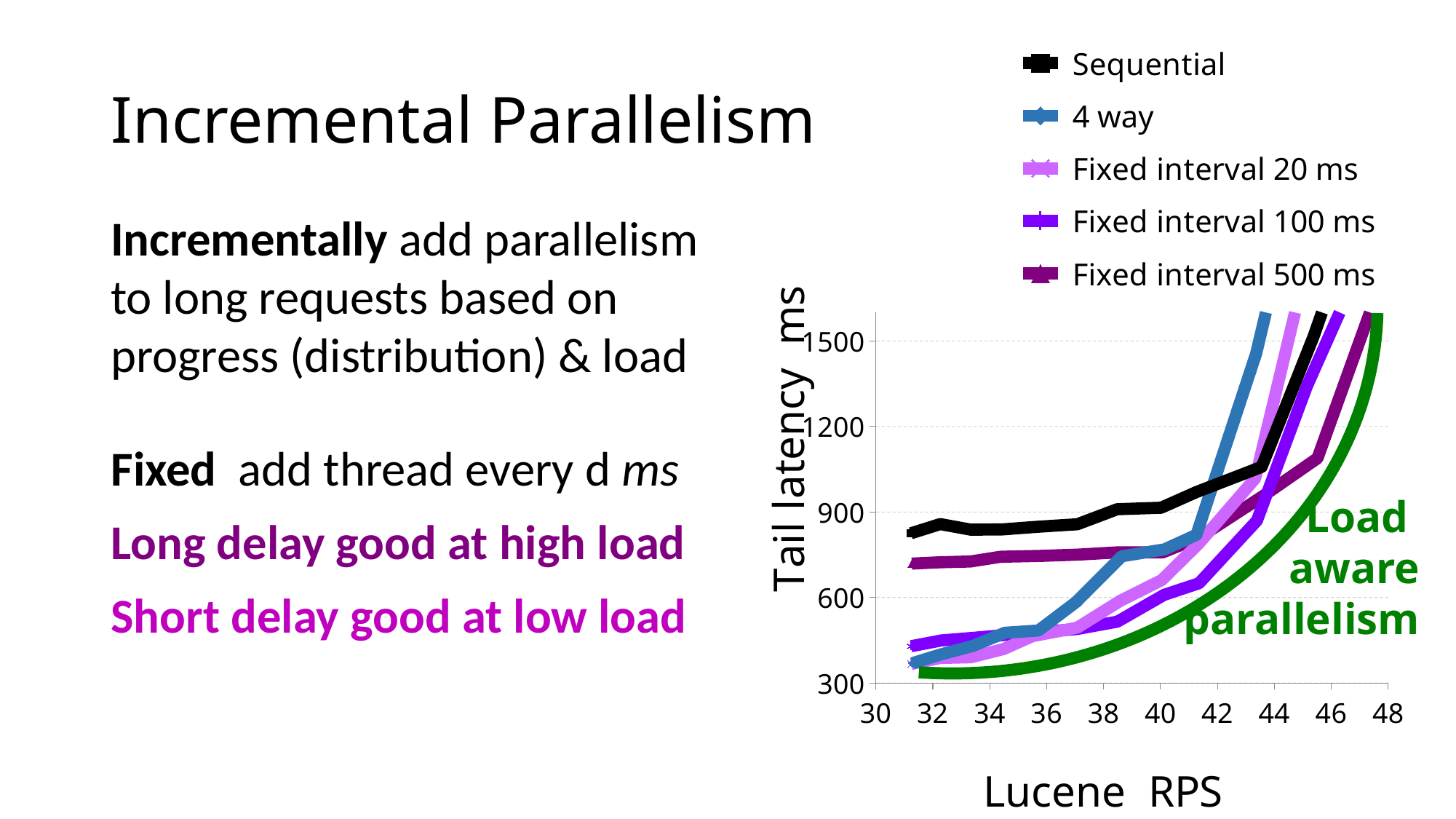
Is the tail latency for the 4 way series at 32 RPS greater or less than 600 ms? less What is the label of the x axis of the chart? Lucene RPS What is the label of the y axis of the chart? Tail latency ms What kind of chart is shown on the slide? line chart At 34 RPS, which has the higher tail latency: Fixed interval 500 ms or Fixed interval 20 ms? Fixed interval 500 ms Does the tail latency for the Sequential series rise or fall as Lucene RPS increases? rise Is the tail latency for the Load aware parallelism line at 36 RPS greater or less than 600 ms? less Is the tail latency for the Fixed interval 500 ms series at 34 RPS greater or less than 900 ms? less Which series has the highest tail latency at 32 RPS? Sequential How many series does the chart's legend list? 5 At 32 RPS, which has the higher tail latency: Sequential or 4 way? Sequential